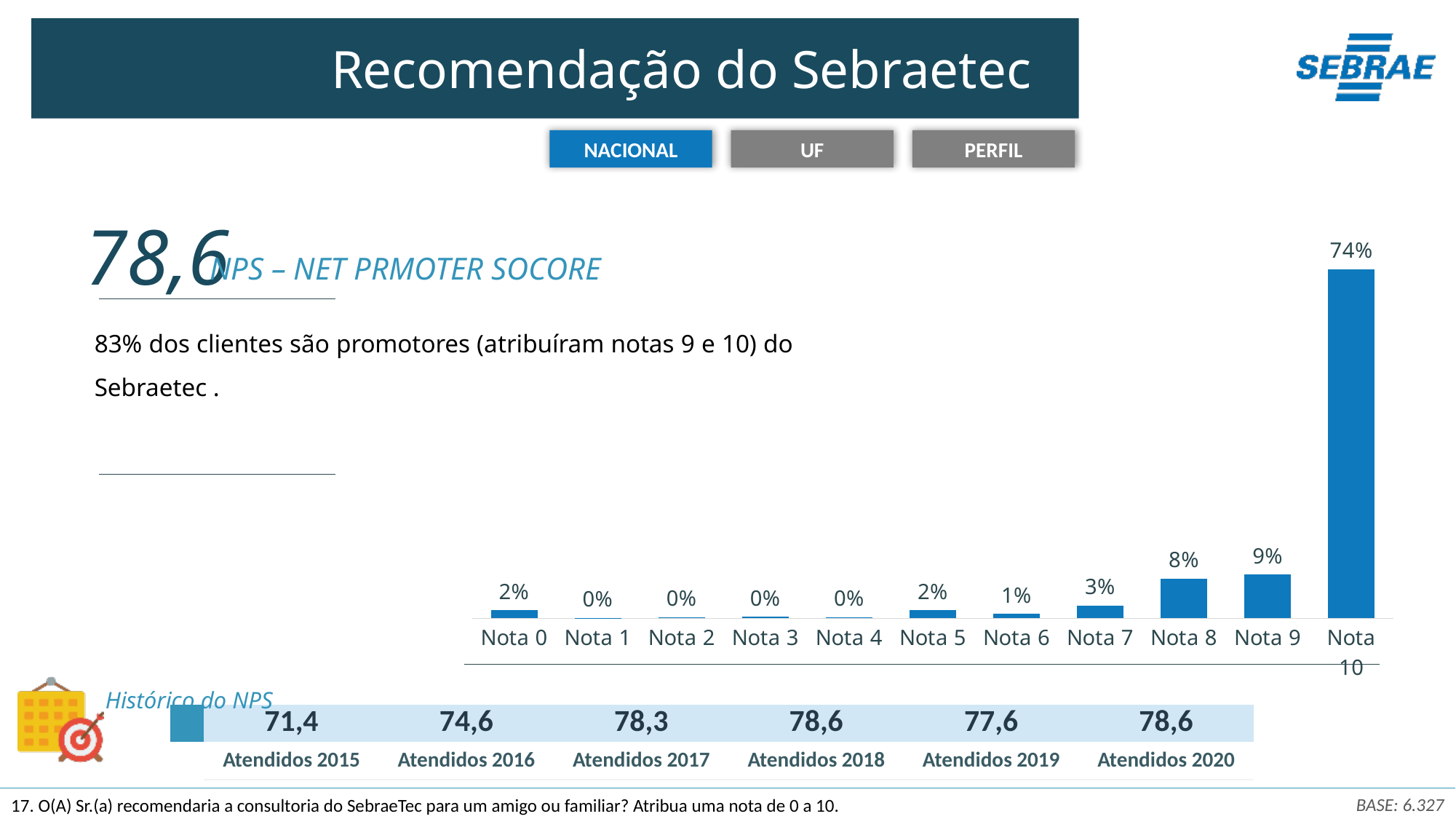
What is the value shown for Nota 8? 8% What is the combined percentage for Nota 9 and Nota 10? 83% What is the value shown for Nota 7? 3% How many nota categories are shown on the x axis of the bar chart? 11 What is the value shown for Nota 9? 9% Which nota has the highest percentage in the bar chart? Nota 10 What is the value shown for Nota 0? 2% Which is larger, the value for Nota 8 or the value for Nota 9? Nota 9 What percentage of clients gave Nota 10? 74% What is the difference between the values for Nota 10 and Nota 9? 65% What kind of chart is used to show the distribution of notas? Bar chart What is the value shown for Nota 6? 1%